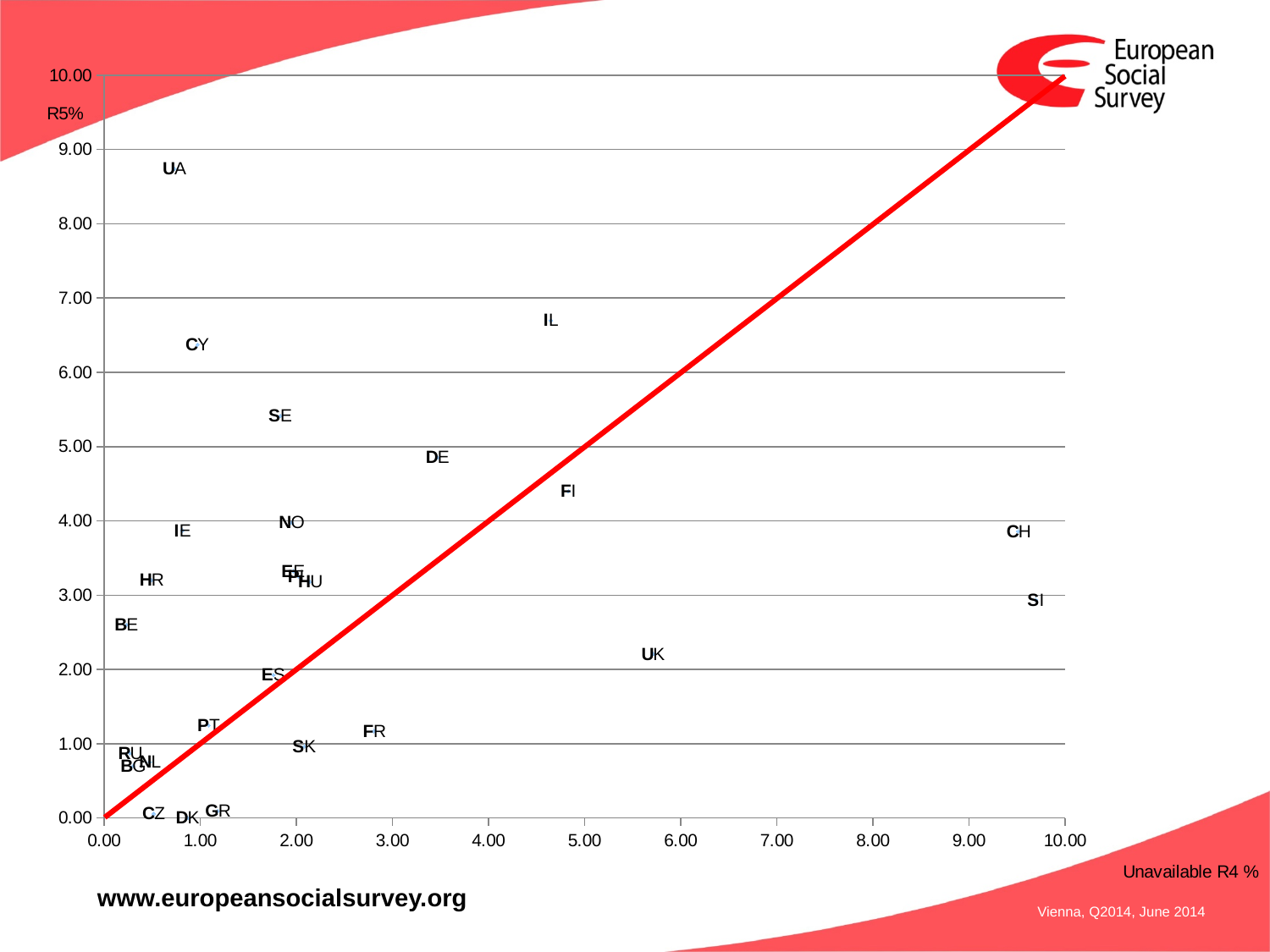
Which has the higher R5% value, CH or SI? CH What kind of chart is shown on the slide? scatter chart Which country has the highest Unavailable R4 % value on the chart? SI Which has the higher R5% value, IL or FI? IL Is the R5% value for UA greater or less than 8.00? greater Is the R5% value for UK greater or less than 3.00? less Is the Unavailable R4 % value for CH greater or less than 9.00? greater What is the label on the horizontal axis of the chart? Unavailable R4 % What is the label on the vertical axis of the chart? R5% Which country has the highest R5% value on the chart? UA